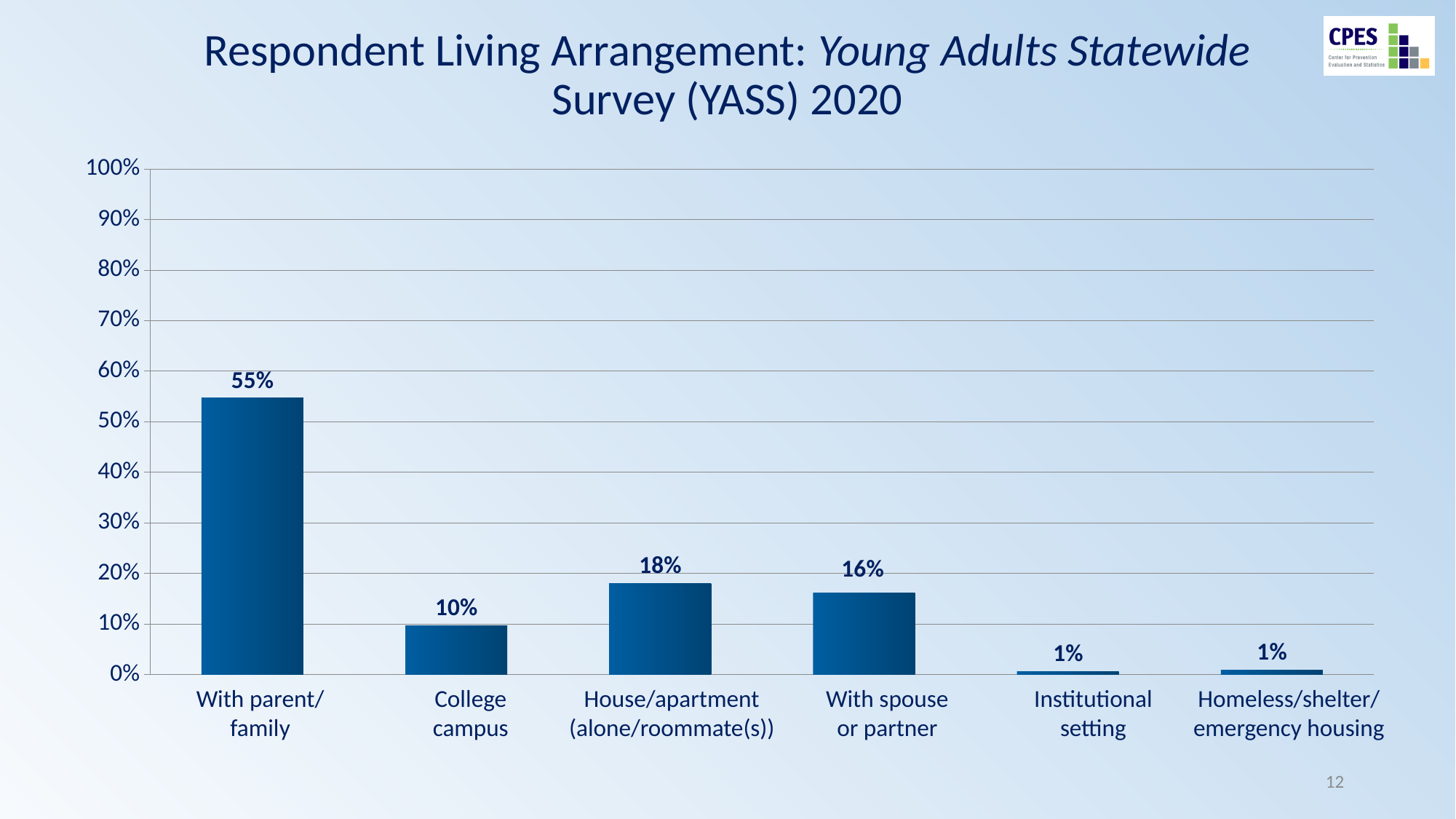
Which living arrangement has the highest percentage of respondents? With parent/family Which is larger: the percentage living in a house/apartment (alone/roommate(s)) or the percentage living with a spouse or partner? House/apartment (alone/roommate(s)) What percentage of respondents live in an institutional setting? 1% What percentage of respondents live with parent/family? 55% Is the value for With parent/family greater or less than 50%? greater What is the maximum value shown on the vertical axis? 100% What percentage of respondents live with a spouse or partner? 16% What is the difference in percentage points between respondents living with parent/family and those living on a college campus? 45% How many living arrangement categories are shown on the chart? 6 What kind of chart is shown on the slide? Bar chart What percentage of respondents live on a college campus? 10% What percentage of respondents live in a house/apartment (alone/roommate(s))? 18%